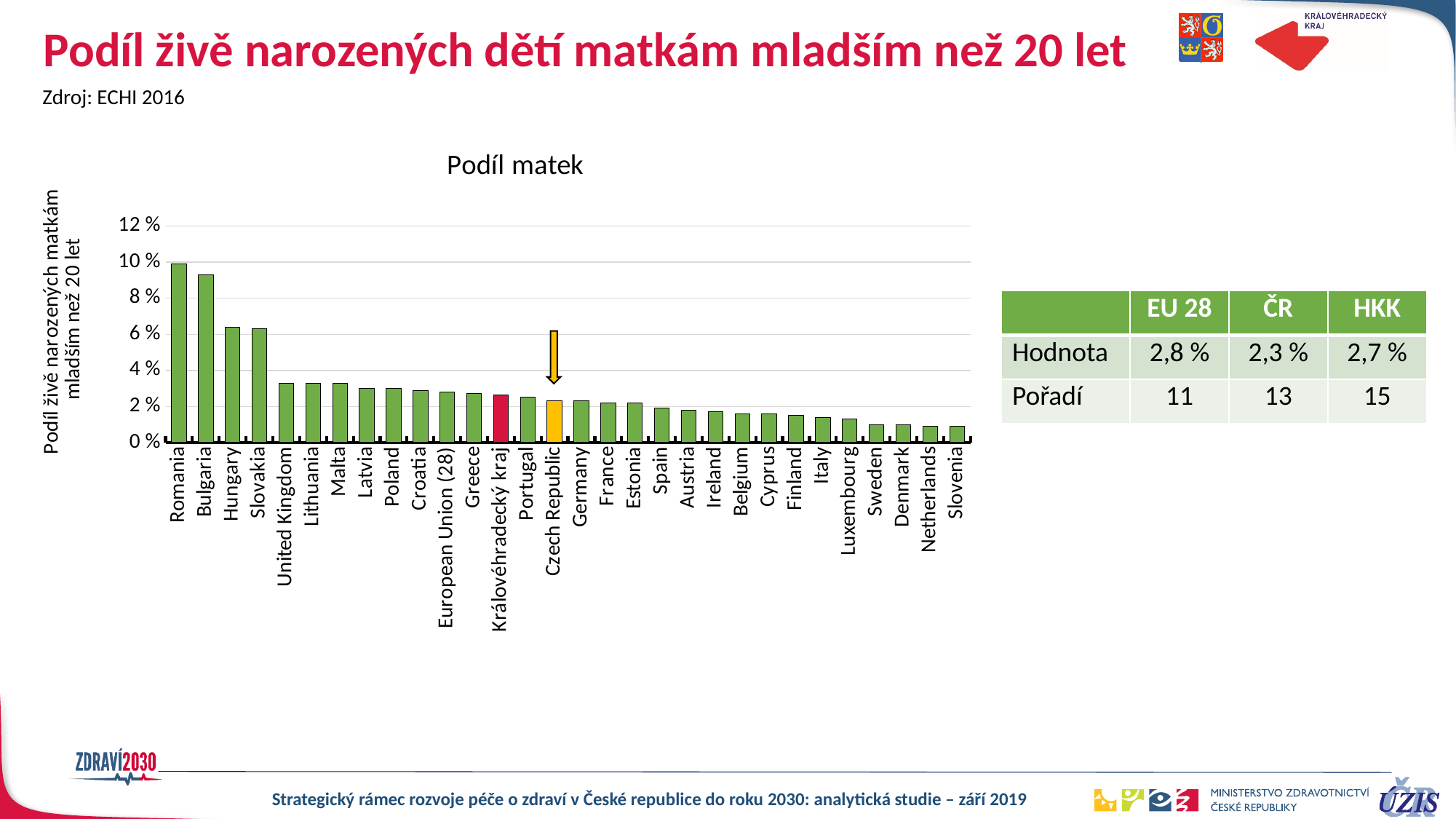
Which has the larger value, Hungary or United Kingdom? Hungary Which category has the highest value in the chart? Romania Which has the larger value, Romania or Bulgaria? Romania Is the value for Hungary greater or less than 4 %? greater What is the title of the chart? Podíl matek How many bars (categories) does the chart show? 30 Do the values rise or fall from left to right along the x axis? fall Which bar in the chart is coloured red? Královéhradecký kraj According to the table on the slide, what is the value (Hodnota) for ČR? 2,3 % Is the value for Slovenia greater or less than 2 %? less What kind of chart is shown on the slide? bar chart Is the value for Romania greater or less than 8 %? greater